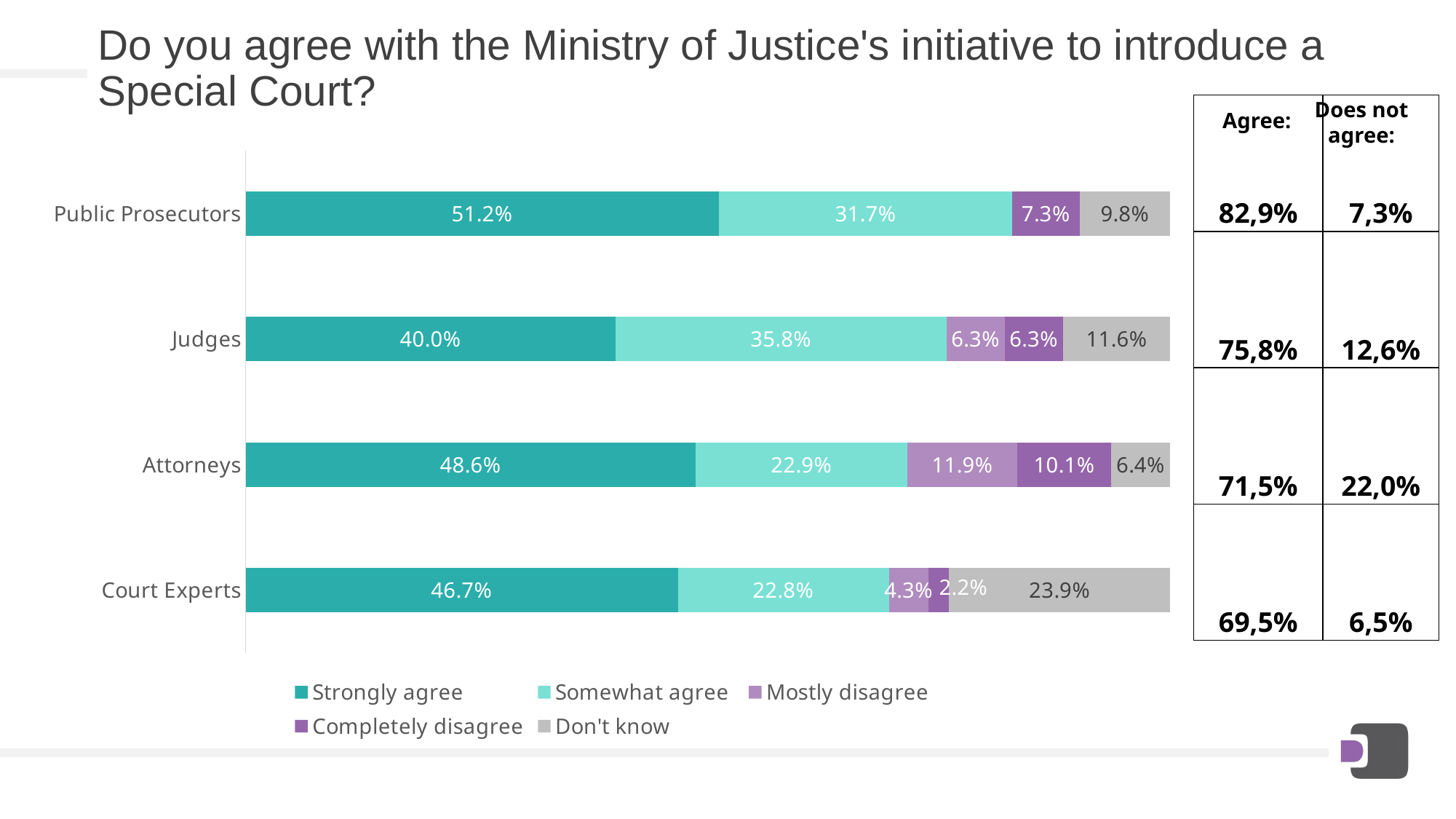
What is the 'Don't know' value for Court Experts? 23.9% Which group has the highest 'Don't know' value? Court Experts How many groups are shown on the chart? 4 What is the difference between the 'Somewhat agree' values for Judges and Attorneys? 12.9% What type of chart is shown? Stacked bar chart Which group has the highest 'Strongly agree' value? Public Prosecutors What is the 'Somewhat agree' value for Judges? 35.8% How many series does the legend list? 5 Which group has the lowest 'Strongly agree' value? Judges Which is larger: the 'Completely disagree' value for Attorneys or for Judges? Attorneys What percentage of Public Prosecutors strongly agree? 51.2% What percentage of Attorneys mostly disagree? 11.9%